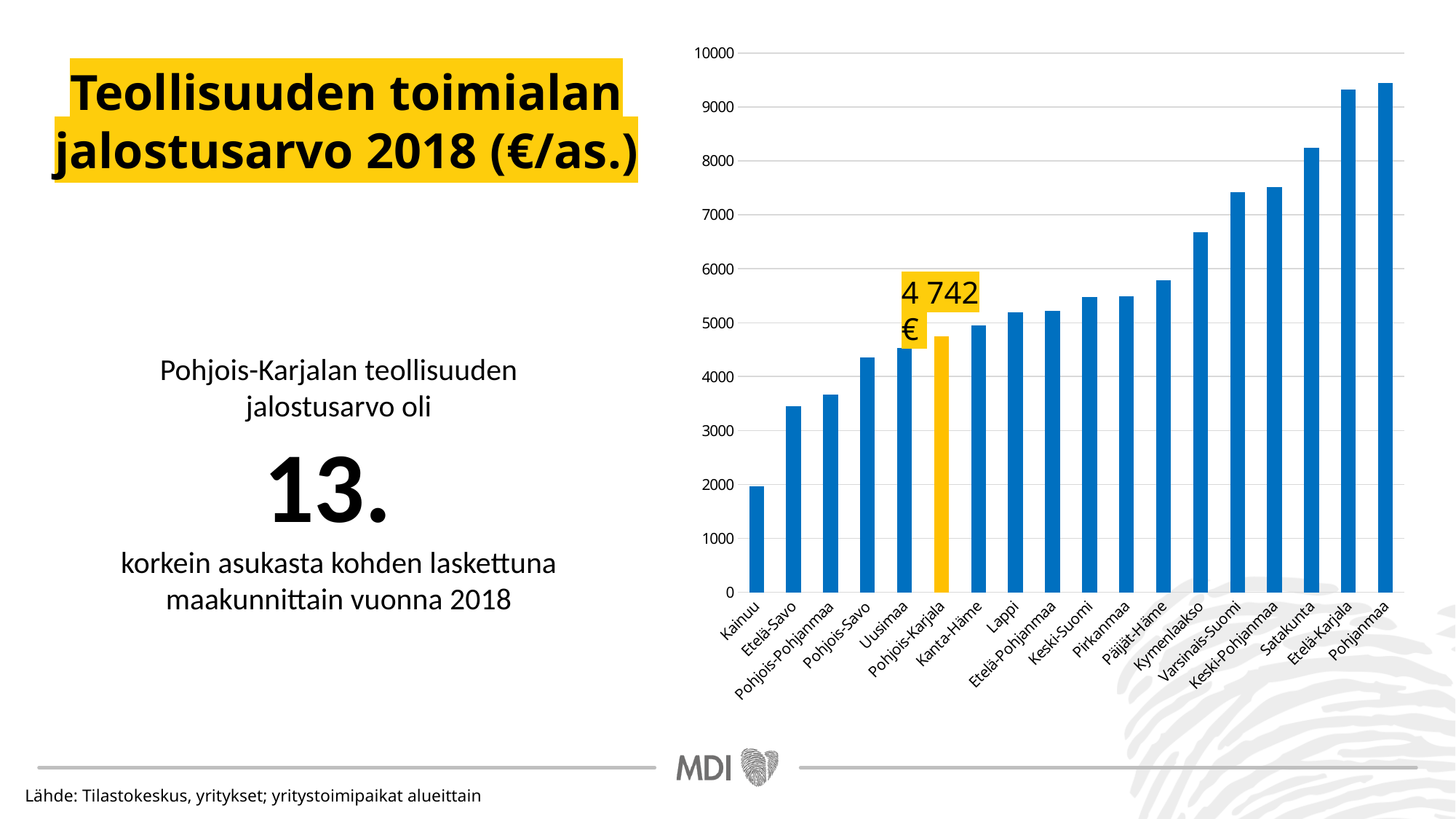
Which bar is highlighted in yellow in the chart? Pohjois-Karjala Is the value for Pohjanmaa greater or less than 9000? greater Do the values rise or fall moving from left to right along the x axis? rise How many regions (bars) are shown in the chart? 18 Which region has the lowest value in the chart? Kainuu Which is larger, the value for Satakunta or the value for Kymenlaakso? Satakunta Is the value for Kainuu greater or less than 3000? less Is the value for Kymenlaakso greater or less than 6000? greater Which is larger, the value for Kainuu or the value for Etelä-Savo? Etelä-Savo What type of chart is shown on the slide? bar chart What is the value for Pohjois-Karjala? 4 742 €